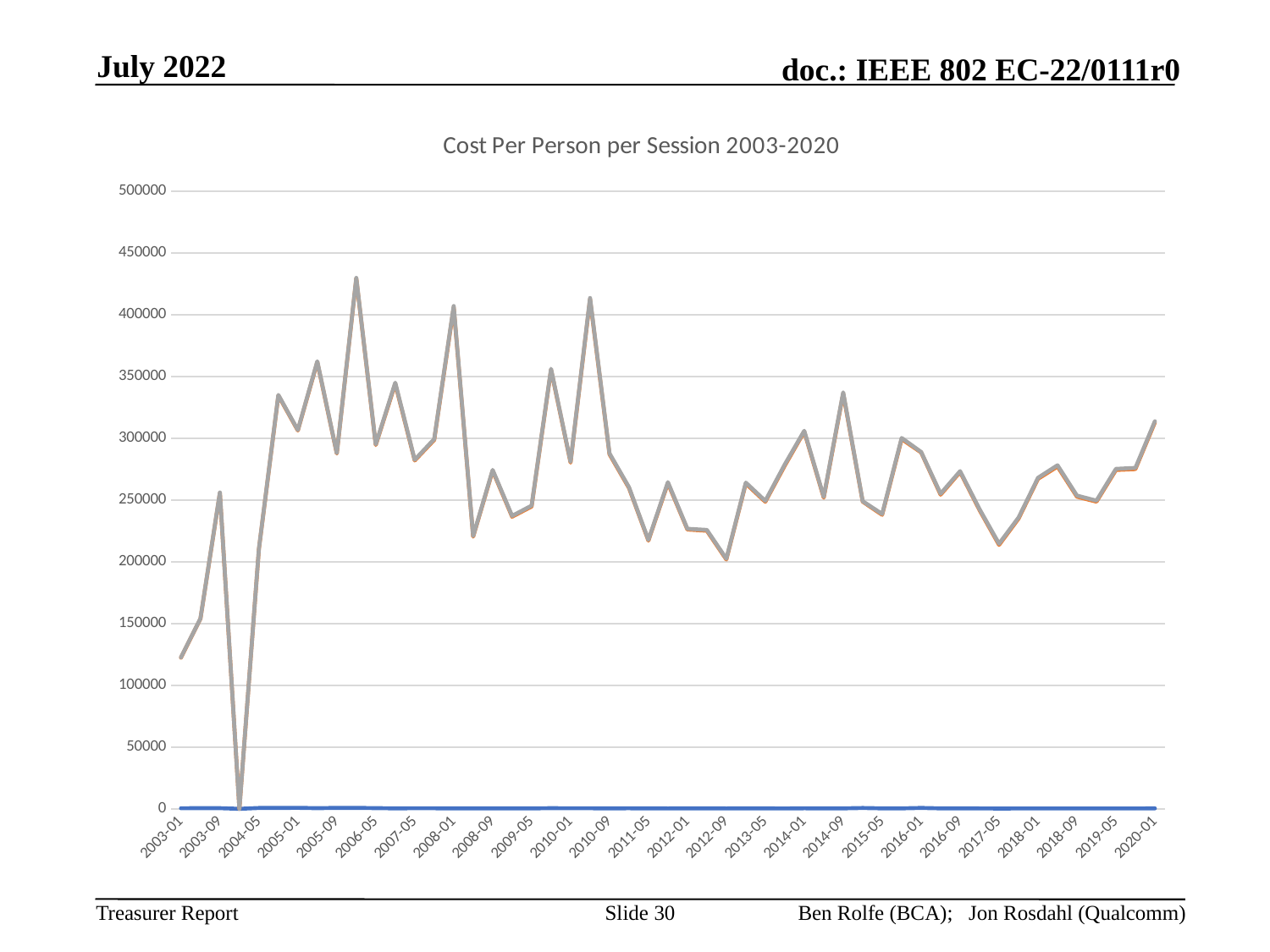
Does the upper line rise or fall from 2017-05 to 2020-01? rise What kind of chart is shown on the slide? line chart Is the value of the upper line at 2017-05 greater or less than 250000? less Which has the larger value on the upper line, 2014-09 or 2015-05? 2014-09 What is the highest value shown on the vertical axis? 500000 Is the value of the upper line at 2003-01 greater or less than 150000? less What is the title of the chart? Cost Per Person per Session 2003-2020 Which has the larger value on the upper line, 2005-01 or 2003-01? 2005-01 Is the value of the upper line at 2005-01 greater or less than 300000? greater